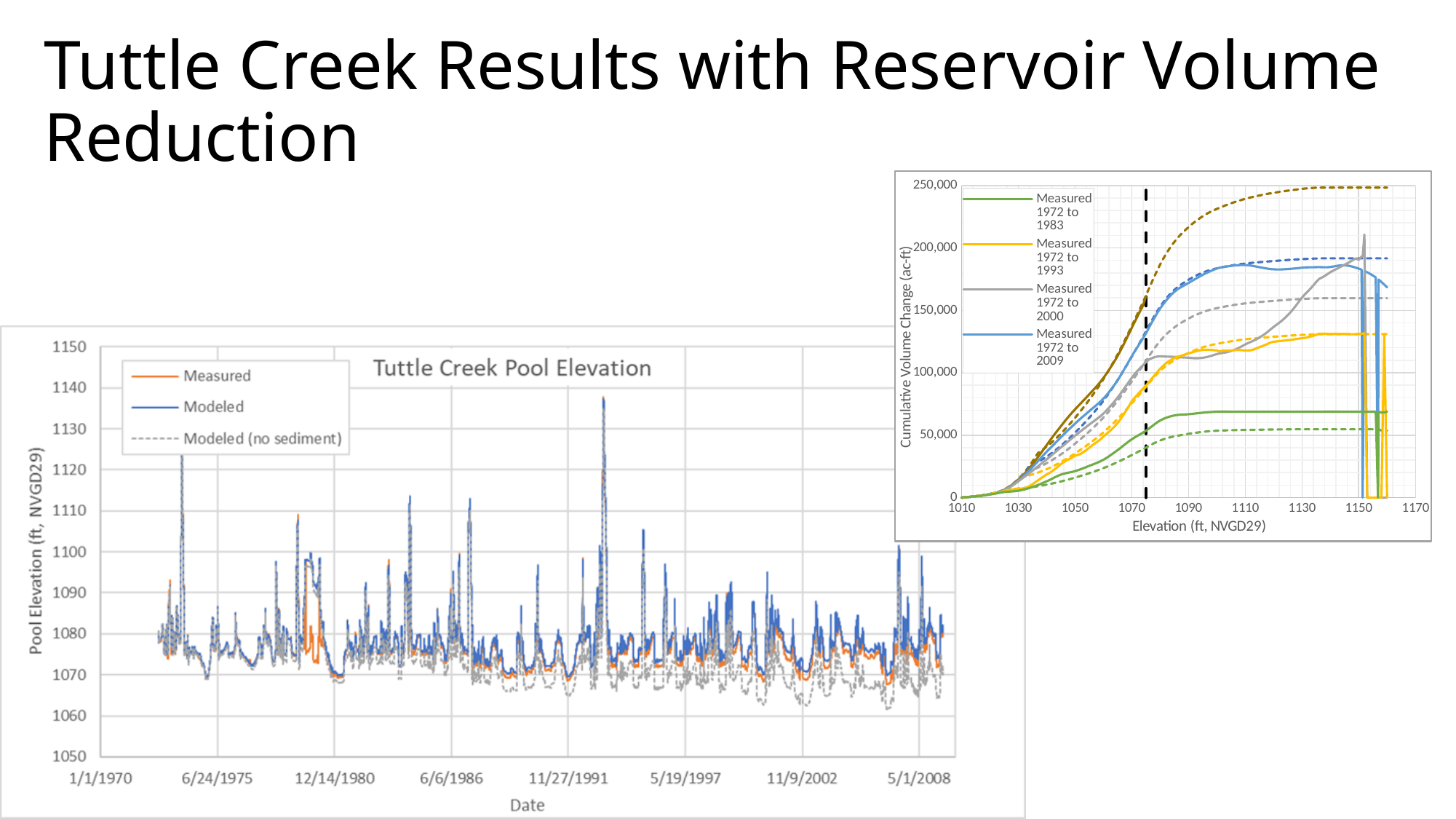
What kind of chart is the Tuttle Creek Pool Elevation chart? line chart What kind of chart is the cumulative volume change chart on the right? line chart In the cumulative volume change chart on the right, which legend series has the lowest cumulative volume change at elevation 1110? Measured 1972 to 1983 In the cumulative volume change chart on the right, which is larger at elevation 1110: the Measured 1972 to 1993 series or the Measured 1972 to 1983 series? Measured 1972 to 1993 In the Tuttle Creek Pool Elevation chart, which series is drawn with a dashed line? Modeled (no sediment) In the cumulative volume change chart on the right, do the measured series rise or fall as elevation increases from 1010 to 1090? rise What is the y-axis label of the Tuttle Creek Pool Elevation chart? Pool Elevation (ft, NVGD29) In the cumulative volume change chart on the right, is the value of the Measured 1972 to 1983 series at elevation 1110 greater or less than 100,000? less How many series does the legend of the cumulative volume change chart on the right list? 4 In the Tuttle Creek Pool Elevation chart, is the highest peak of the Modeled series (around 1993) greater or less than 1130? greater In the cumulative volume change chart on the right, is the value of the Measured 1972 to 2009 series at elevation 1110 greater or less than 150,000? greater How many series does the legend of the Tuttle Creek Pool Elevation chart list? 3